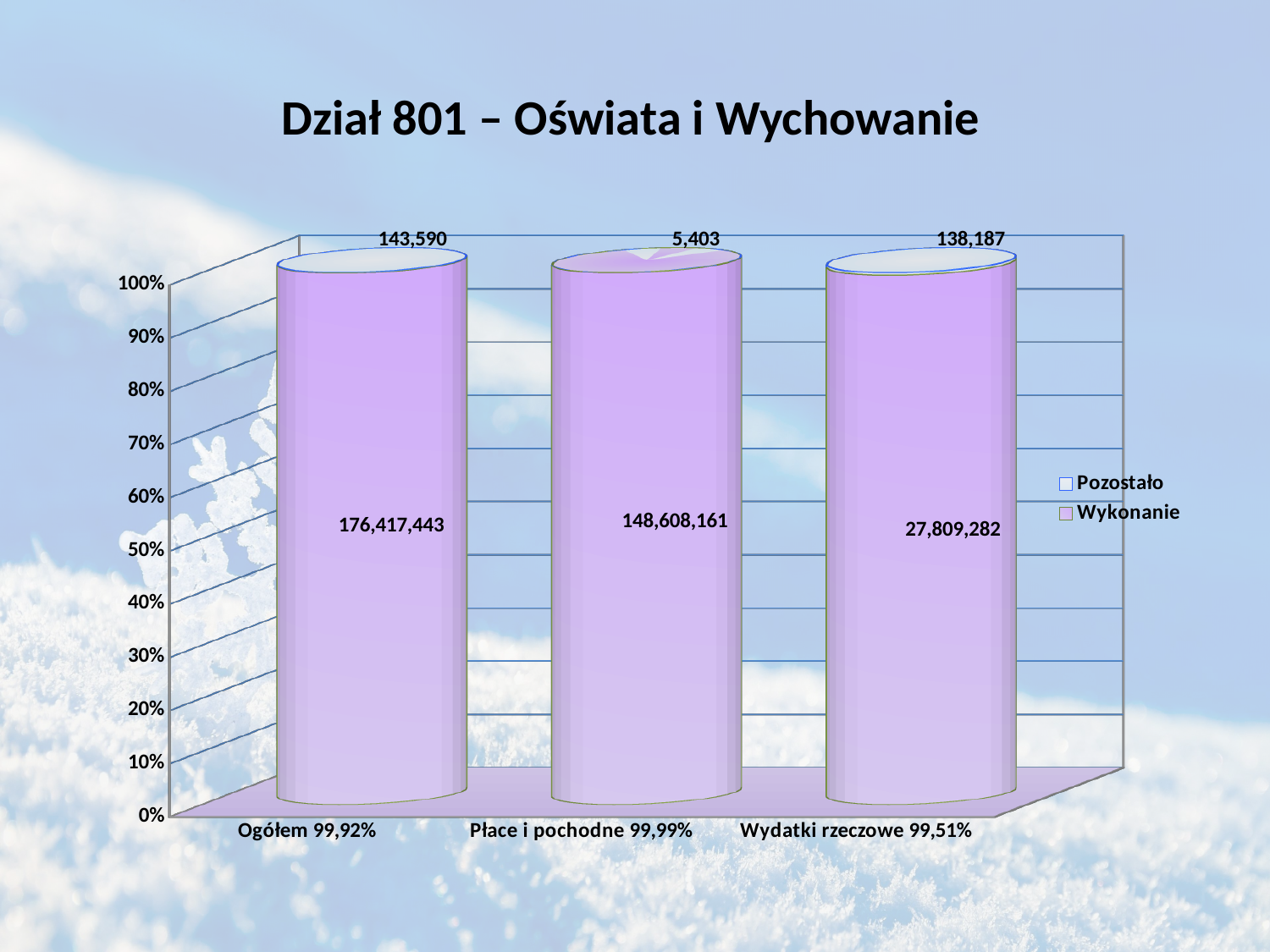
What is the difference between the Wykonanie values for Ogółem 99,92% and Płace i pochodne 99,99%? 27,809,282 What is the Wykonanie value for Ogółem 99,92%? 176,417,443 What is the title of the chart? Dział 801 – Oświata i Wychowanie What type of chart is shown on the slide? Stacked bar chart Which category has the lowest Pozostało value? Płace i pochodne 99,99% What is the Pozostało value for Wydatki rzeczowe 99,51%? 138,187 How many series does the legend list? 2 What is the total of the Wykonanie and Pozostało values for Płace i pochodne 99,99%? 148,613,564 What is the Pozostało value for Płace i pochodne 99,99%? 5,403 What is the Wykonanie value for Wydatki rzeczowe 99,51%? 27,809,282 How many categories are shown on the x axis? 3 Which category has the highest Wykonanie value? Ogółem 99,92%